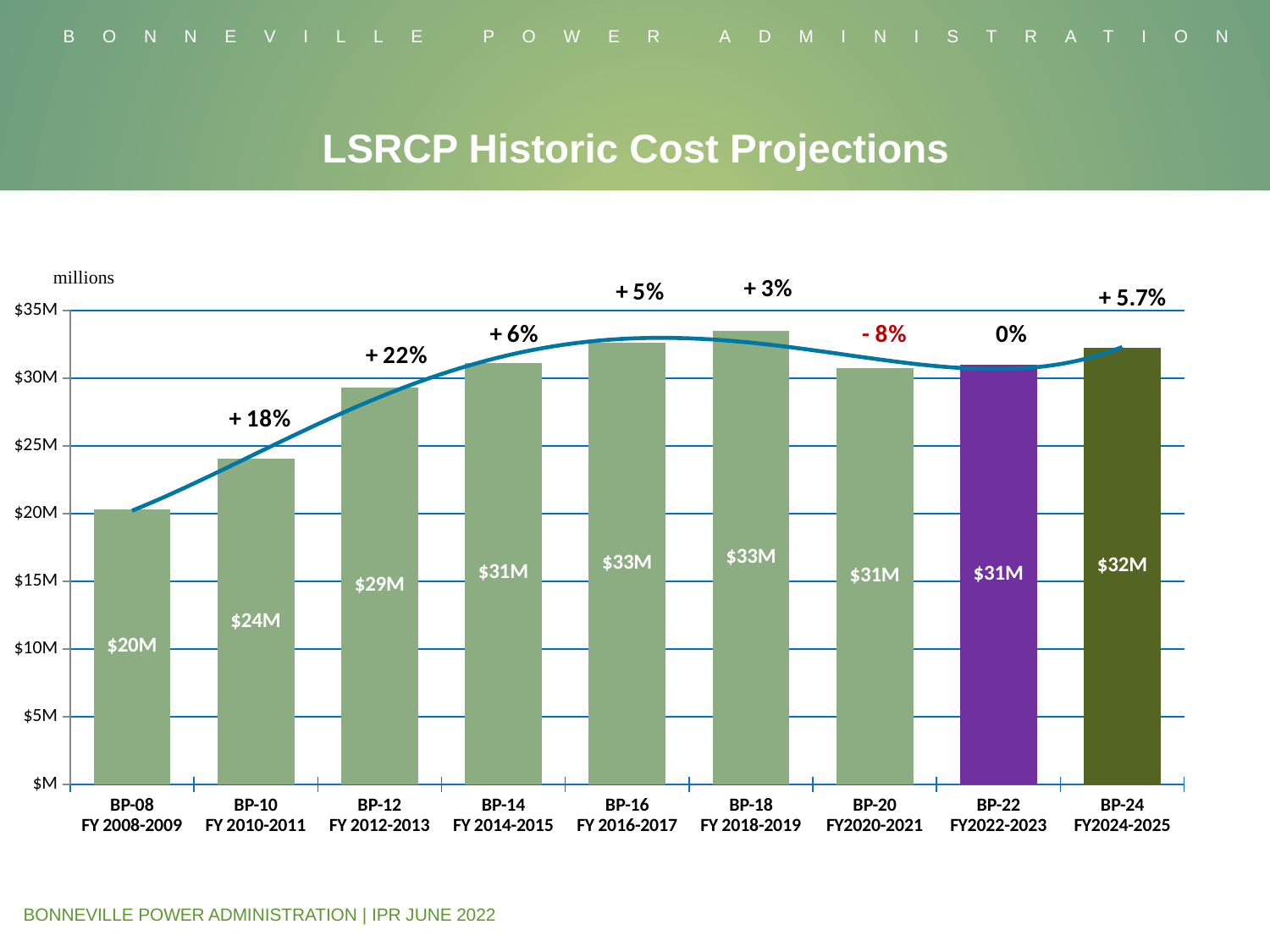
What is the value for BP-24 (FY2024-2025)? $32M How many budget periods are shown on the x axis? 9 What percentage change is shown above the BP-12 bar? + 22% Which is larger, the value for BP-12 or the value for BP-10? BP-12 What is the value for BP-22 (FY2022-2023)? $31M Which budget period has the lowest value? BP-08 What is the value for BP-08 (FY 2008-2009)? $20M Do the values rise or fall from BP-08 to BP-18? Rise What kind of chart is shown on the slide? Bar chart What percentage change is shown above the BP-20 bar? - 8% What is the difference between the BP-24 value and the BP-08 value? $12M Is the value for BP-10 greater or less than $20M? greater